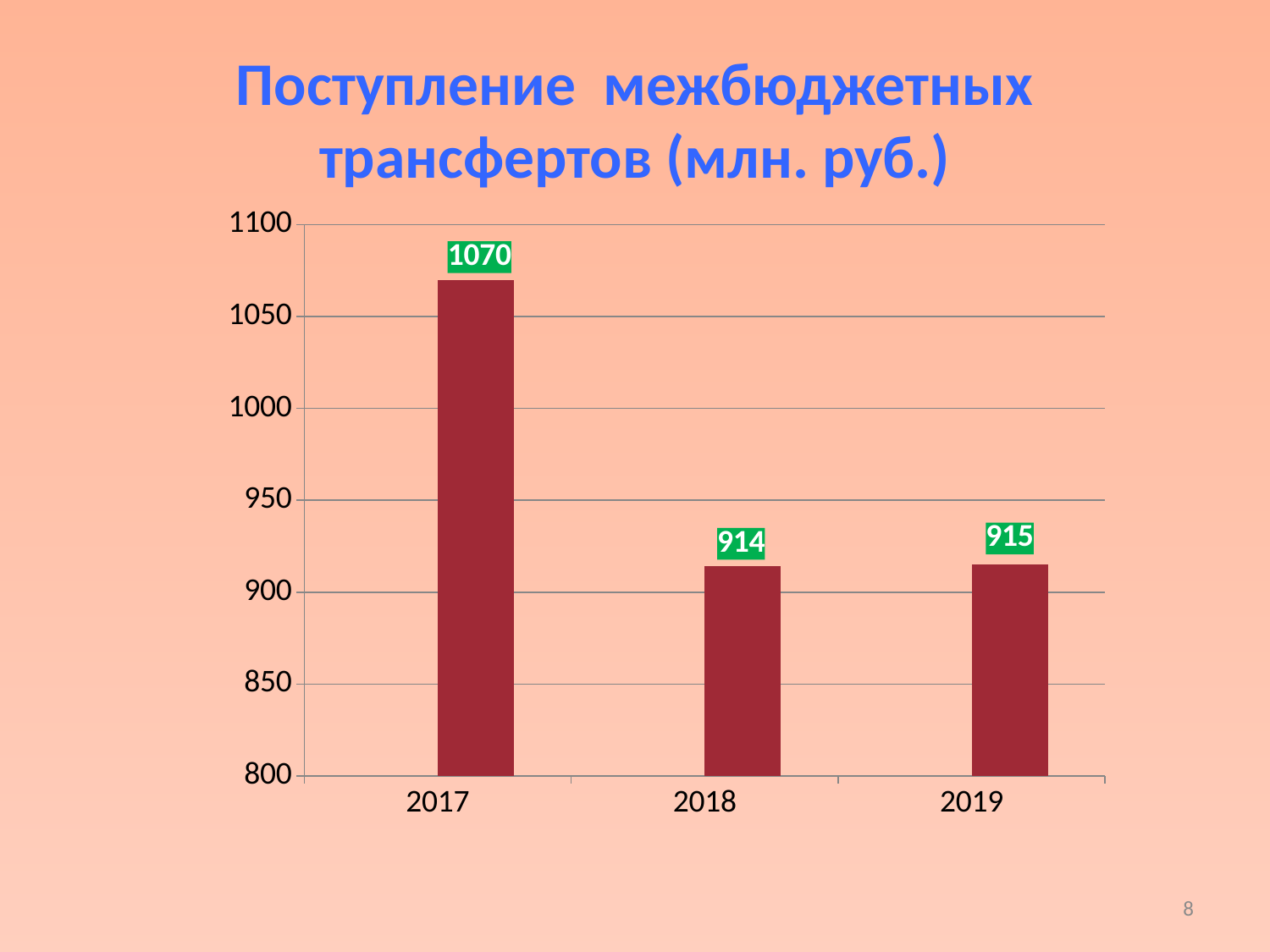
Is the value for 2018 greater or less than 950? less What is the title of the chart? Поступление межбюджетных трансфертов (млн. руб.) What is the value for 2018? 914 Which is larger, the value for 2017 or the value for 2019? 2017 What kind of chart is shown on the slide? bar chart What is the value for 2019? 915 What is the difference between the values for 2017 and 2018? 156 What is the difference between the values for 2019 and 2018? 1 What is the value for 2017? 1070 Which year has the highest value? 2017 How many years are shown on the chart? 3 Which year has the lowest value? 2018